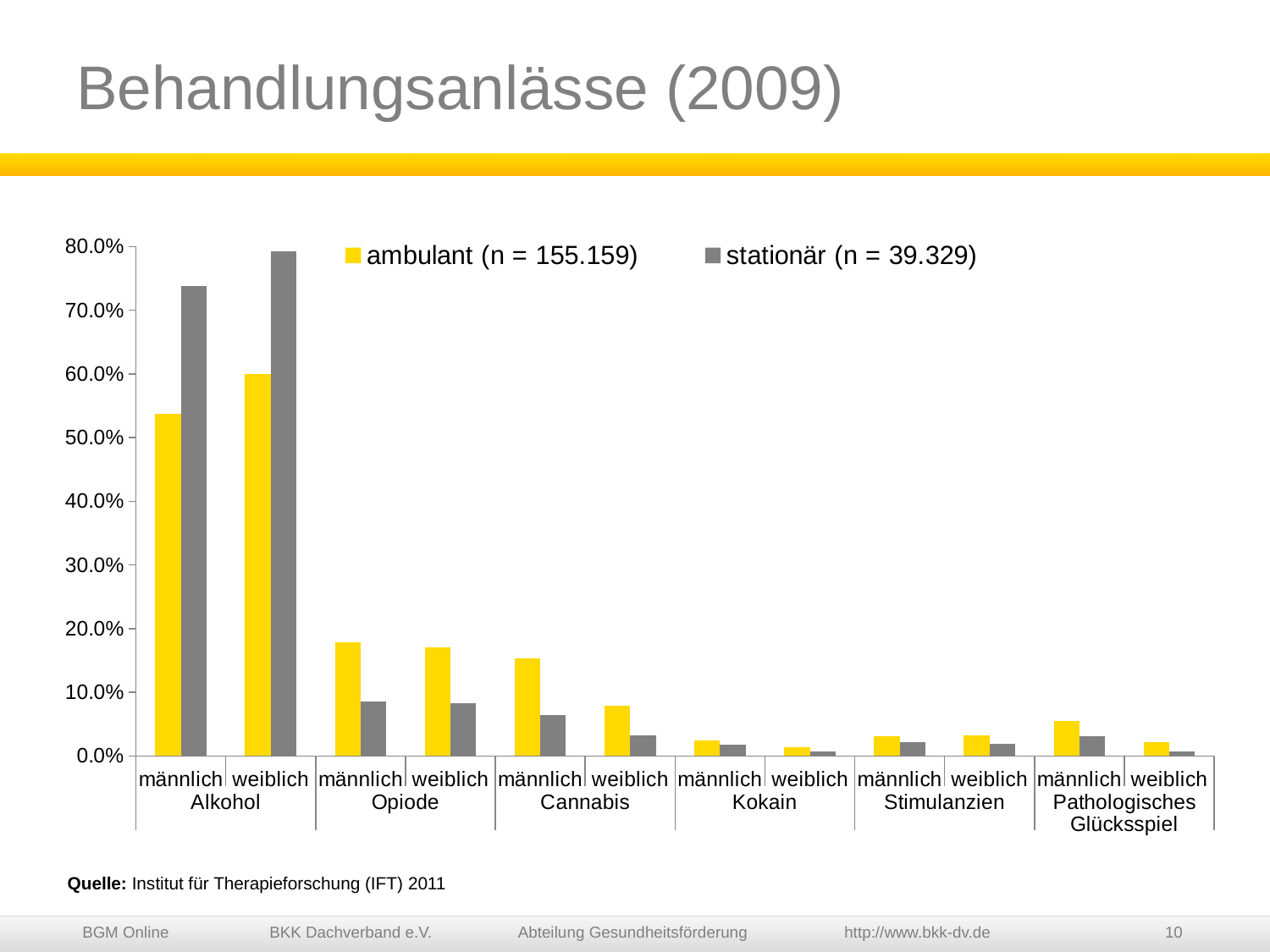
What is the sample size (n) given in the legend for the ambulant series? 155.159 For Cannabis männlich, which series has the larger value, ambulant or stationär? ambulant Which bar is the highest in the chart? stationär, Alkohol weiblich Is the ambulant value for Alkohol männlich greater or less than 50.0%? greater Is the stationär value for Cannabis männlich greater or less than 10.0%? less Is the ambulant value for Opiode männlich greater or less than 10.0%? greater What kind of chart is shown on the slide? bar chart How many series does the legend list? 2 For Alkohol weiblich, which series has the larger value, ambulant or stationär? stationär How many substance groups are shown along the x axis? 6